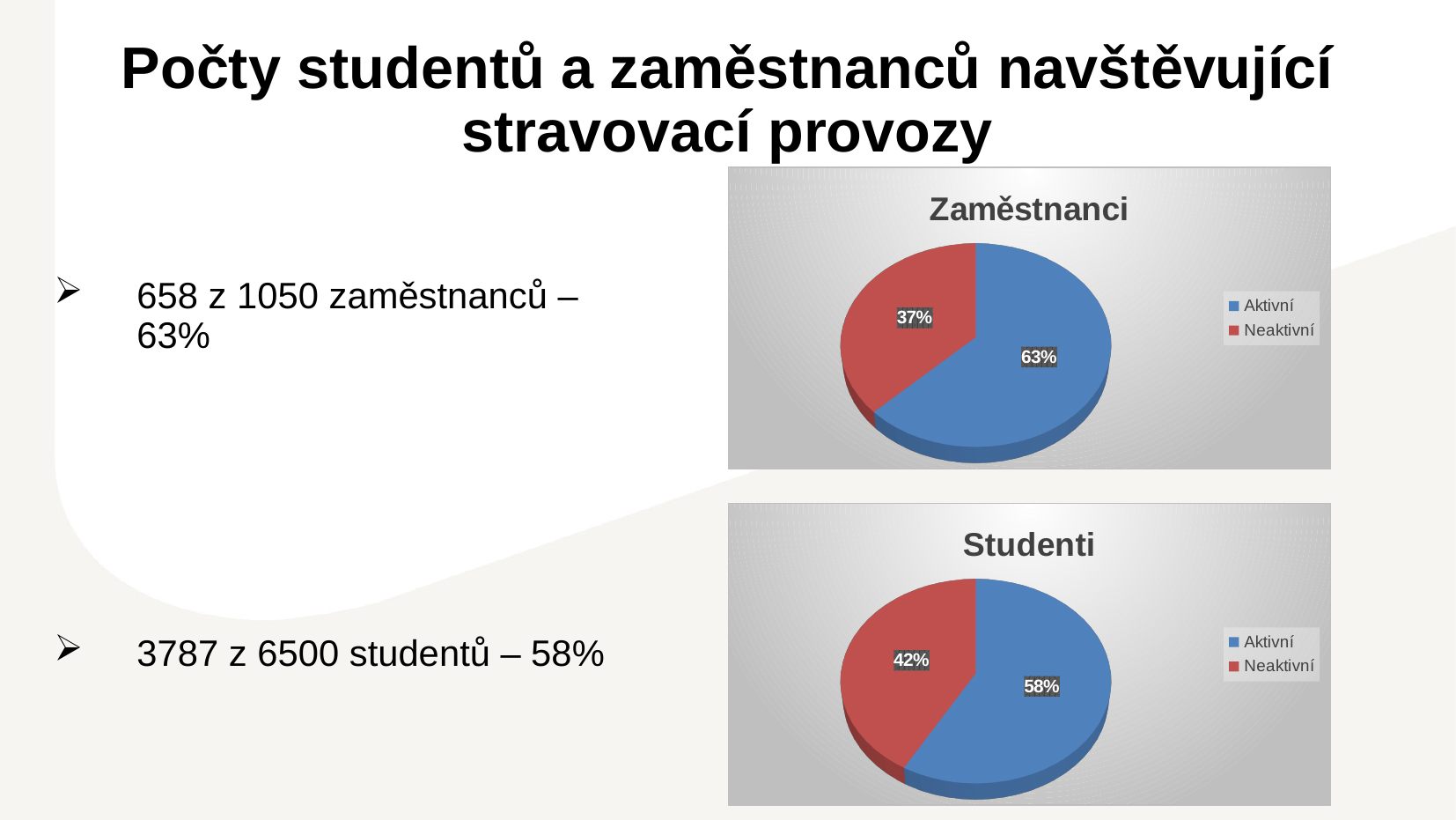
In the 'Studenti' chart, what share of the pie is labelled Aktivní? 58% How many slices does the 'Zaměstnanci' pie chart have? 2 In the 'Studenti' chart, what share of the pie is labelled Neaktivní? 42% How many entries does the legend of the 'Studenti' chart list? 2 What kind of chart is the 'Studenti' chart? Pie chart In the 'Zaměstnanci' chart, what share of the pie is labelled Neaktivní? 37% In the 'Studenti' chart, which slice is the smallest? Neaktivní In the 'Studenti' chart, what is the difference in percentage points between the Aktivní and Neaktivní slices? 16 In the 'Zaměstnanci' chart, what is the difference in percentage points between the Aktivní and Neaktivní slices? 26 In the 'Zaměstnanci' chart, what colour is the Neaktivní slice? Red In the 'Zaměstnanci' chart, which slice is larger, Aktivní or Neaktivní? Aktivní